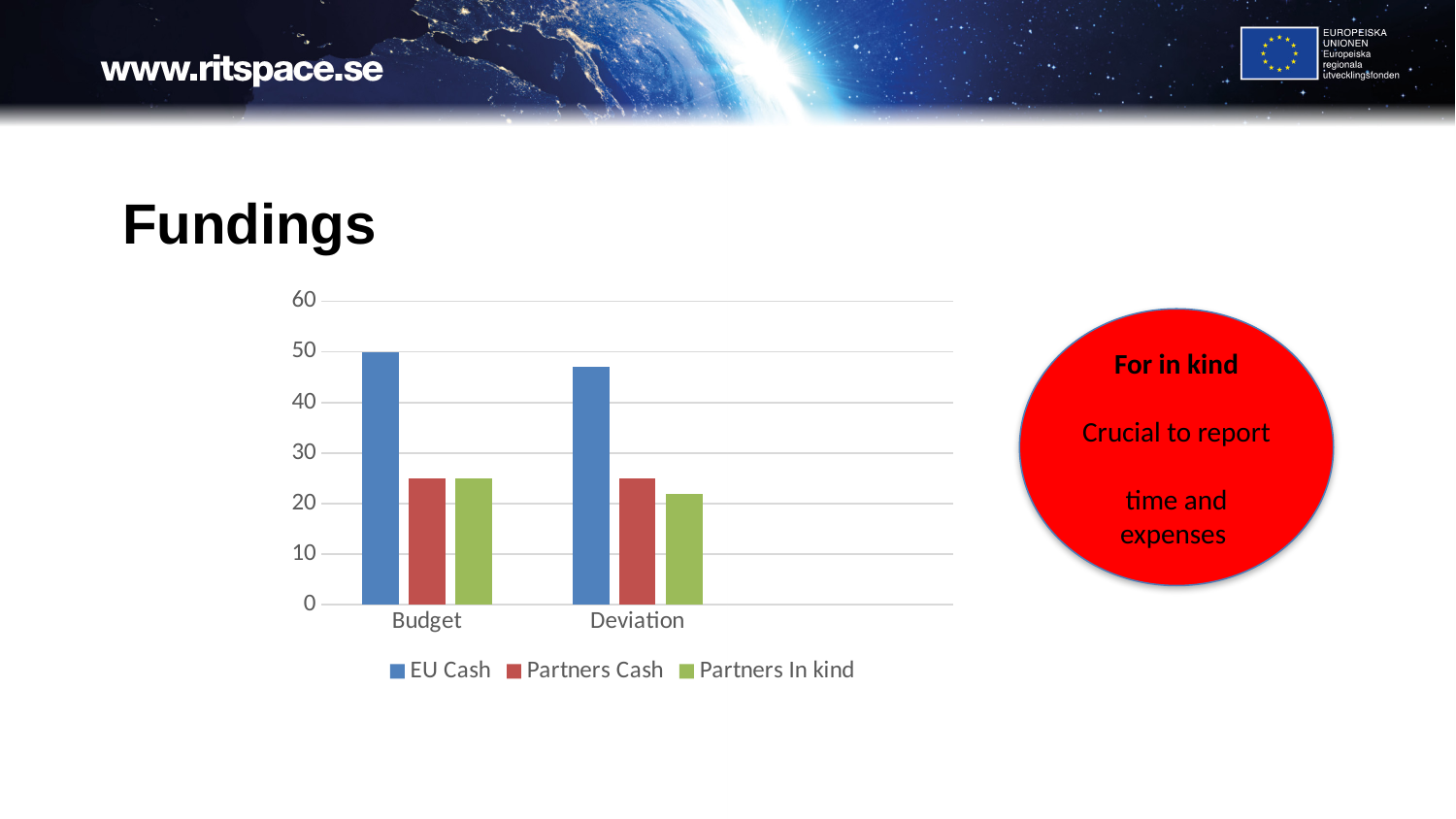
Is the value of EU Cash for Deviation greater or less than 40? greater Which is larger: EU Cash for Budget or EU Cash for Deviation? EU Cash for Budget How many series does the chart legend list? 3 Does the EU Cash value rise or fall from Budget to Deviation? fall How many categories are shown on the x axis of the chart? 2 Is the value of Partners In kind for Deviation greater or less than 30? less What kind of chart is shown on the slide? bar chart Which series has the lowest value for Deviation? Partners In kind What are the three entries in the chart legend? EU Cash, Partners Cash, Partners In kind Which series has the highest value for Budget? EU Cash What is the value of EU Cash for Budget? 50 Is the value of Partners Cash for Budget greater or less than 20? greater